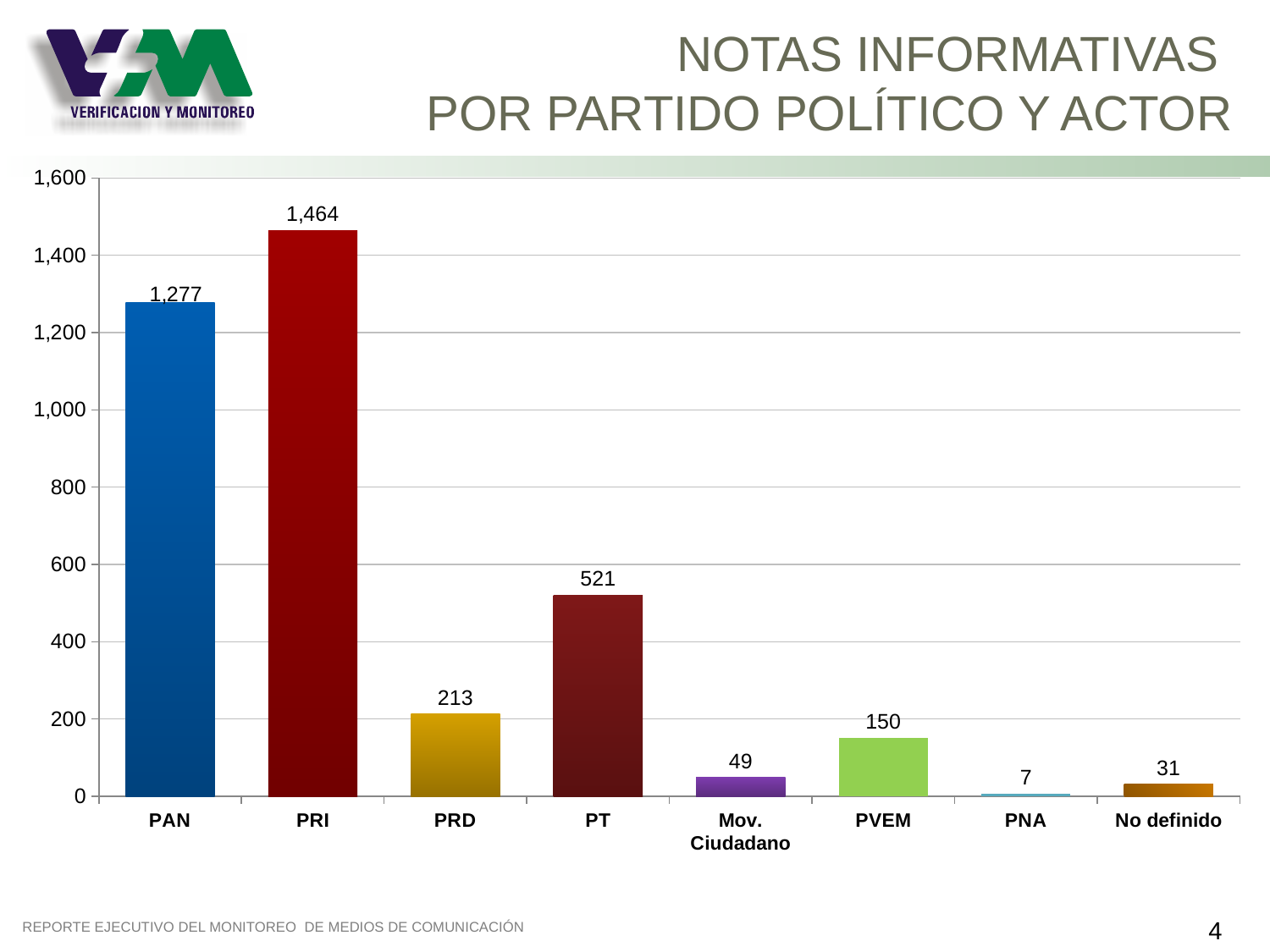
Is the value for PT greater or less than 400? greater Which category has the lowest value? PNA What is the value for No definido? 31 What is the value for PRI? 1,464 What is the value for Mov. Ciudadano? 49 What is the difference between the values for PT and PRD? 308 What kind of chart is shown on the slide? bar chart What is the value for PAN? 1,277 What is the difference between the values for PRI and PAN? 187 How many categories are shown on the x axis? 8 Which category has the highest value? PRI Which is larger, the value for PVEM or the value for PRD? PRD